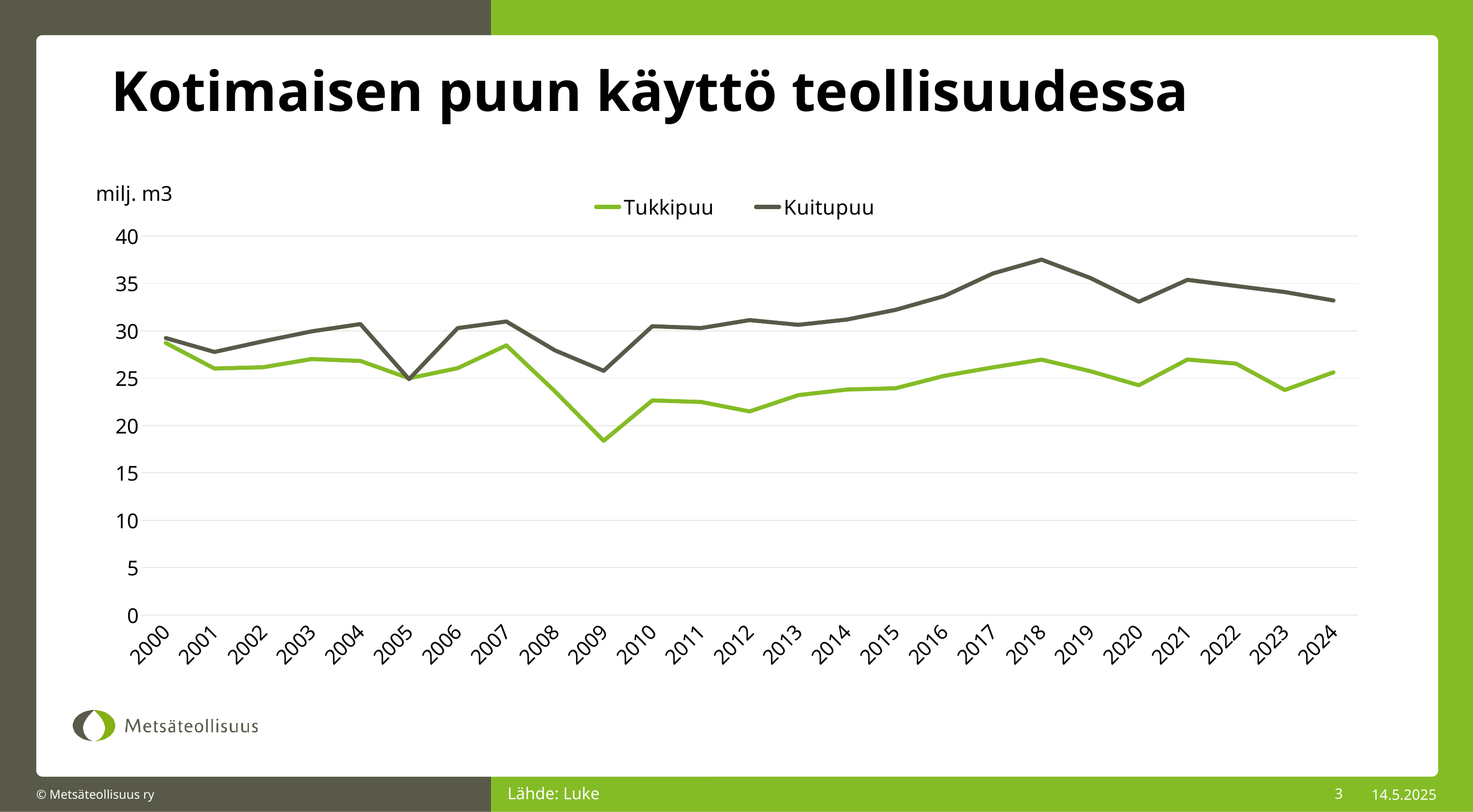
Is the value for Tukkipuu in 2023 greater or less than 25? less In which year does the Tukkipuu series reach its lowest value? 2009 Is the value for Tukkipuu in 2009 greater or less than 20? less How many series does the legend list? 2 Does the Kuitupuu series rise or fall between 2012 and 2018? rise What unit is shown above the y axis? milj. m3 How many years are shown on the x axis? 25 Is the value for Kuitupuu in 2024 greater or less than 30? greater What kind of chart is shown on the slide? line chart In which year does the Kuitupuu series reach its highest value? 2018 In 2010, which series has the larger value, Tukkipuu or Kuitupuu? Kuitupuu